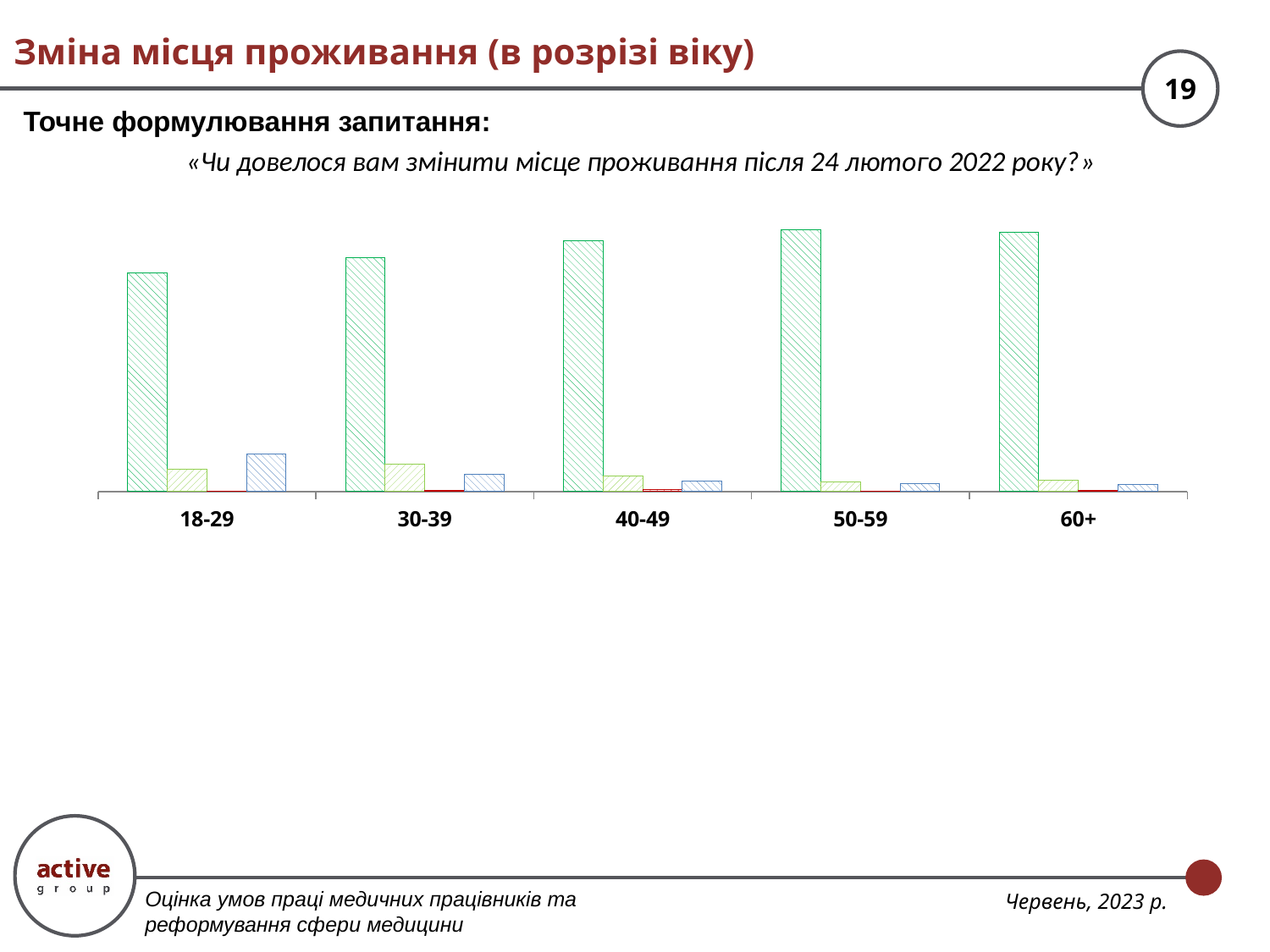
For the green hatched series, is the value for 18-29 or 30-39 larger? 30-39 For the blue series, is the value for 18-29 or 60+ larger? 18-29 Which age category has the lowest value for the tallest (green hatched) series? 18-29 For the green hatched series, is the value for 30-39 or 40-49 larger? 40-49 What kind of chart is shown on the slide? bar chart What is the first age category on the x axis of the chart? 18-29 What is the title of the slide containing the chart? Зміна місця проживання (в розрізі віку) How many bars are plotted for each age category in the chart? 4 Within each age group, which bar is the shortest? the red bar Which age category has the highest value for the blue series (the rightmost bar in each group)? 18-29 Within the 18-29 group, which bar is the tallest? the green hatched bar (first bar) How many age categories are shown on the x axis of the chart? 5